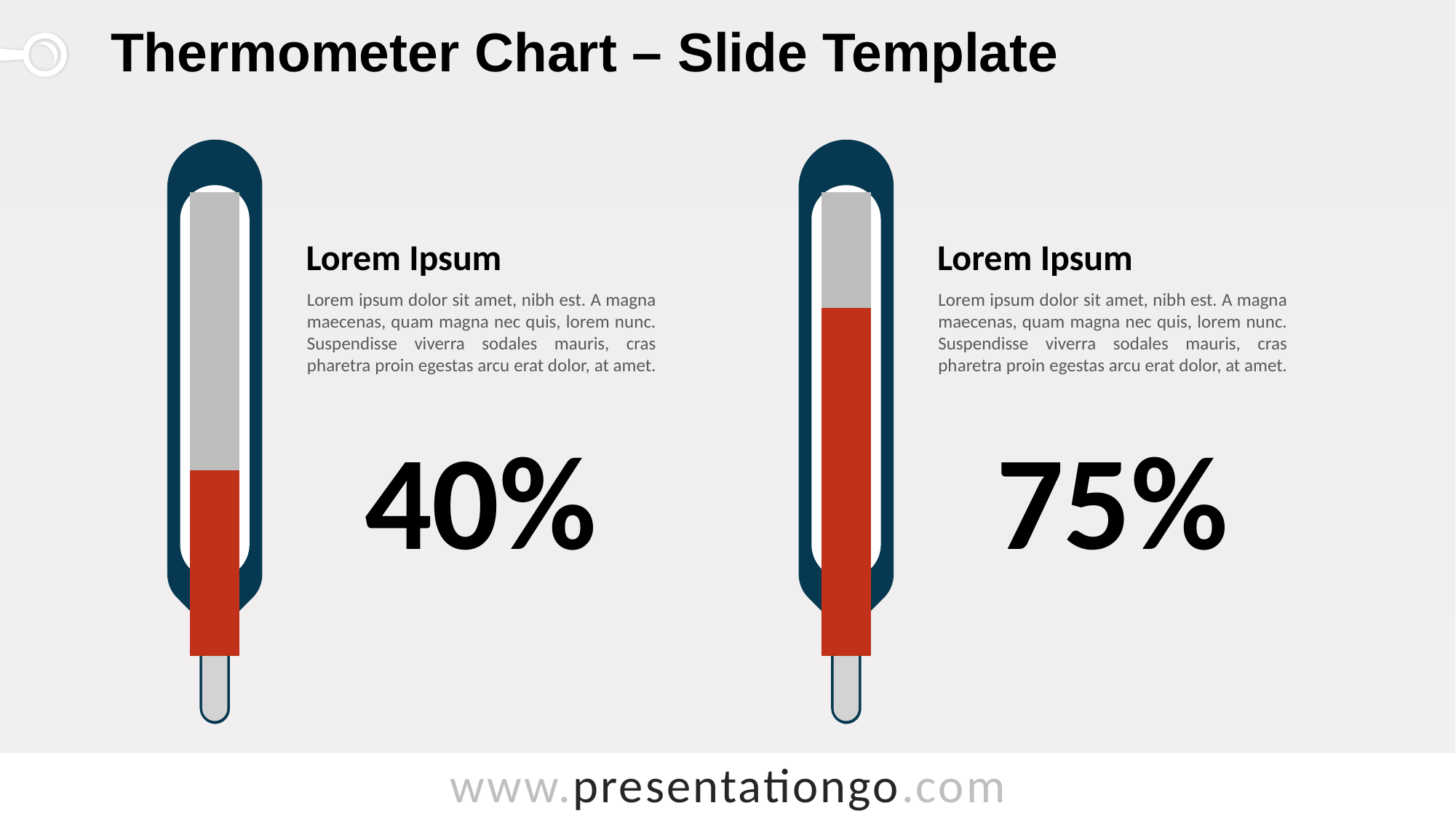
What is the difference between the right thermometer's value and the left thermometer's value? 35% How many thermometer charts are on the slide? 2 What value is shown for the left thermometer chart? 40% What is the title of the slide? Thermometer Chart – Slide Template What kind of chart is used on this slide? thermometer chart Which thermometer chart shows the higher value, the left or the right? the right What value is shown for the right thermometer chart? 75% Is the value for the right thermometer chart greater or less than 50%? greater Which thermometer chart shows the lower value, the left or the right? the left What colour is the filled portion of the thermometers? red Is the value for the left thermometer chart greater or less than 50%? less